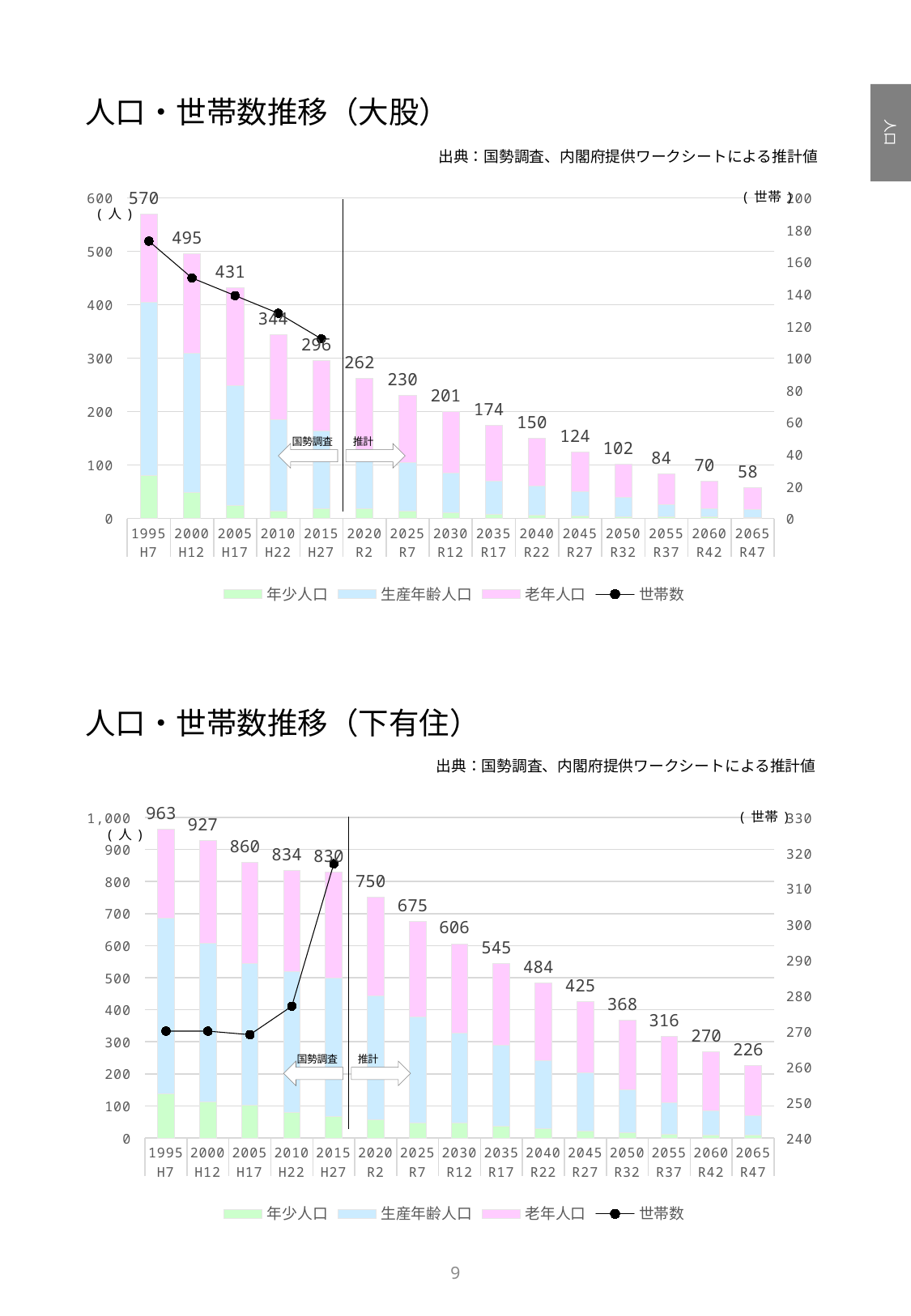
In the 人口・世帯数推移（大股） chart, is the 世帯数 value for 1995 greater or less than 160? greater In the 人口・世帯数推移（下有住） chart, do the total population values rise or fall from 1995 to 2065? fall In the 人口・世帯数推移（下有住） chart, what is the total population labelled for 2020 (R2)? 750 In the 人口・世帯数推移（大股） chart, what is the total population labelled for 2065 (R47)? 58 In the 人口・世帯数推移（大股） chart, which year has the highest total population? 1995 (H7) In the 人口・世帯数推移（下有住） chart, how many years are shown on the x axis? 15 In the 人口・世帯数推移（下有住） chart, which year has the lowest total population? 2065 (R47) In the 人口・世帯数推移（下有住） chart, is the 世帯数 value for 2015 greater or less than 300? greater In the 人口・世帯数推移（大股） chart, what is the total population labelled for 1995 (H7)? 570 In the 人口・世帯数推移（下有住） chart, which is larger, the total population in 2010 or in 2015? 2010 In the 人口・世帯数推移（大股） chart, how many series does the legend list? 4 In the 人口・世帯数推移（大股） chart, what is the difference between the total population in 1995 and in 2065? 512